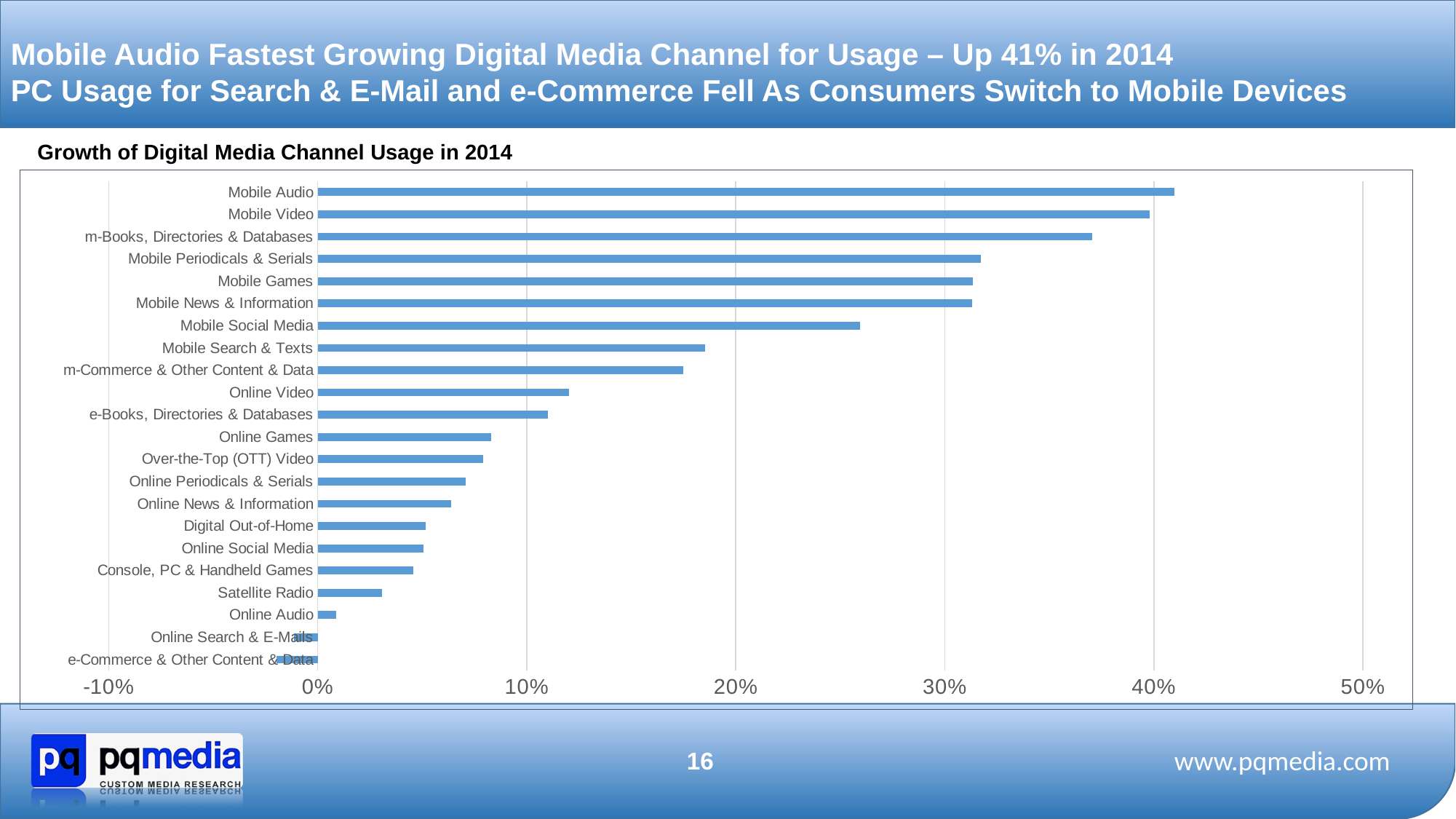
How many channels show negative growth in the chart? 2 What is the title of the chart? Growth of Digital Media Channel Usage in 2014 What kind of chart is shown on the slide? bar chart Is the value for Mobile Video greater or less than 30%? greater How many digital media channels are plotted in the chart? 22 What is the growth value for Mobile Audio? 41% Which channel has the highest growth in the chart? Mobile Audio Is the value for Mobile Social Media greater or less than 20%? greater Which channel has the lowest growth in the chart? e-Commerce & Other Content & Data Which is larger, the value for Mobile Social Media or the value for Online Video? Mobile Social Media Is the value for Online Games greater or less than 10%? less